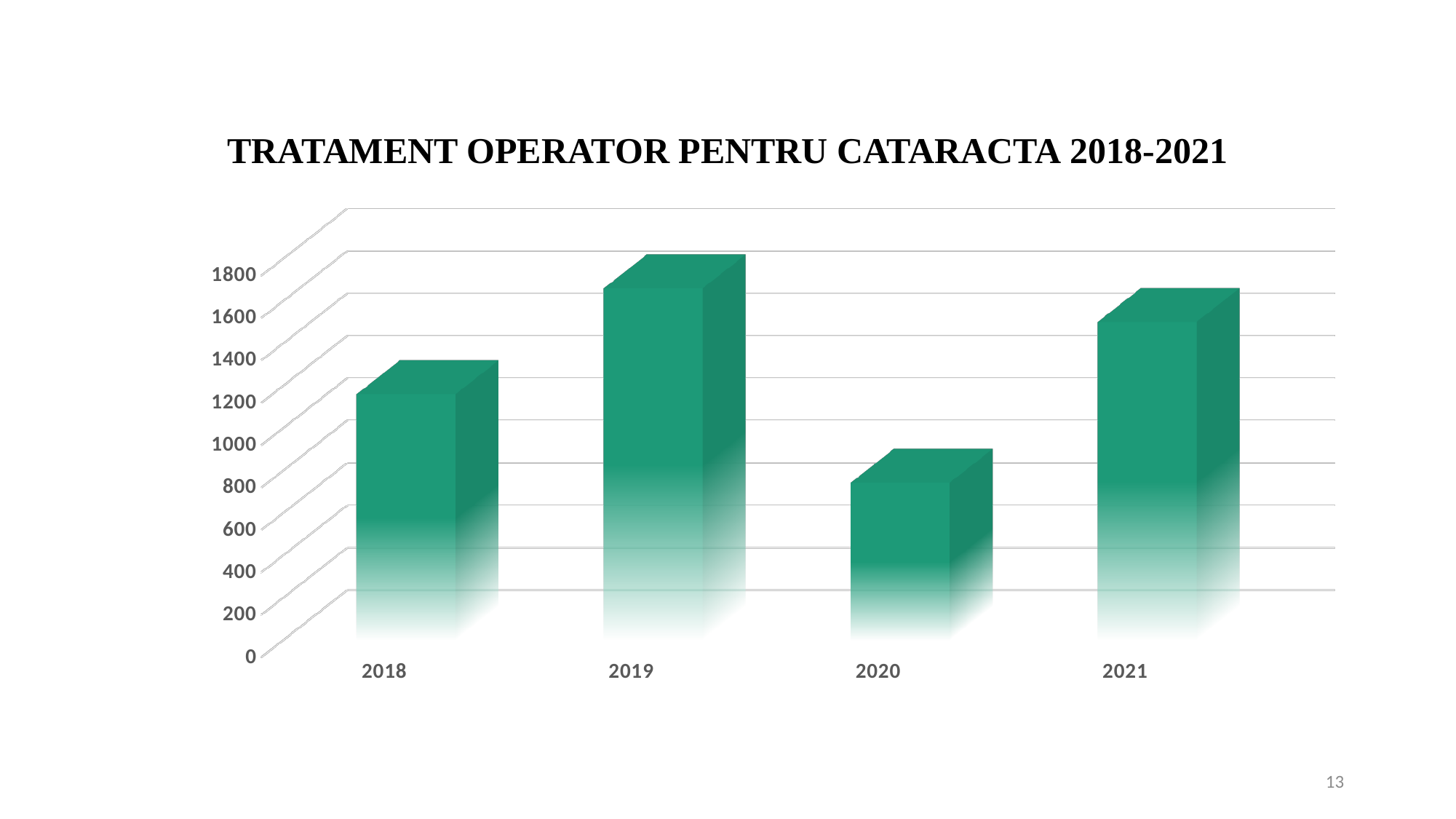
Is the value for 2019 greater or less than 1400? greater Does the value rise or fall from 2019 to 2020? fall How many years are shown on the x axis of the chart? 4 Is the value for 2020 greater or less than 1000? less Which year has the larger value, 2020 or 2018? 2018 Is the value for 2018 greater or less than 1000? greater Which year has the highest bar in the chart? 2019 Which year has the lowest bar in the chart? 2020 Which year has the larger value, 2018 or 2021? 2021 What kind of chart is shown on the slide? bar chart What is the title of the chart? TRATAMENT OPERATOR PENTRU CATARACTA 2018-2021